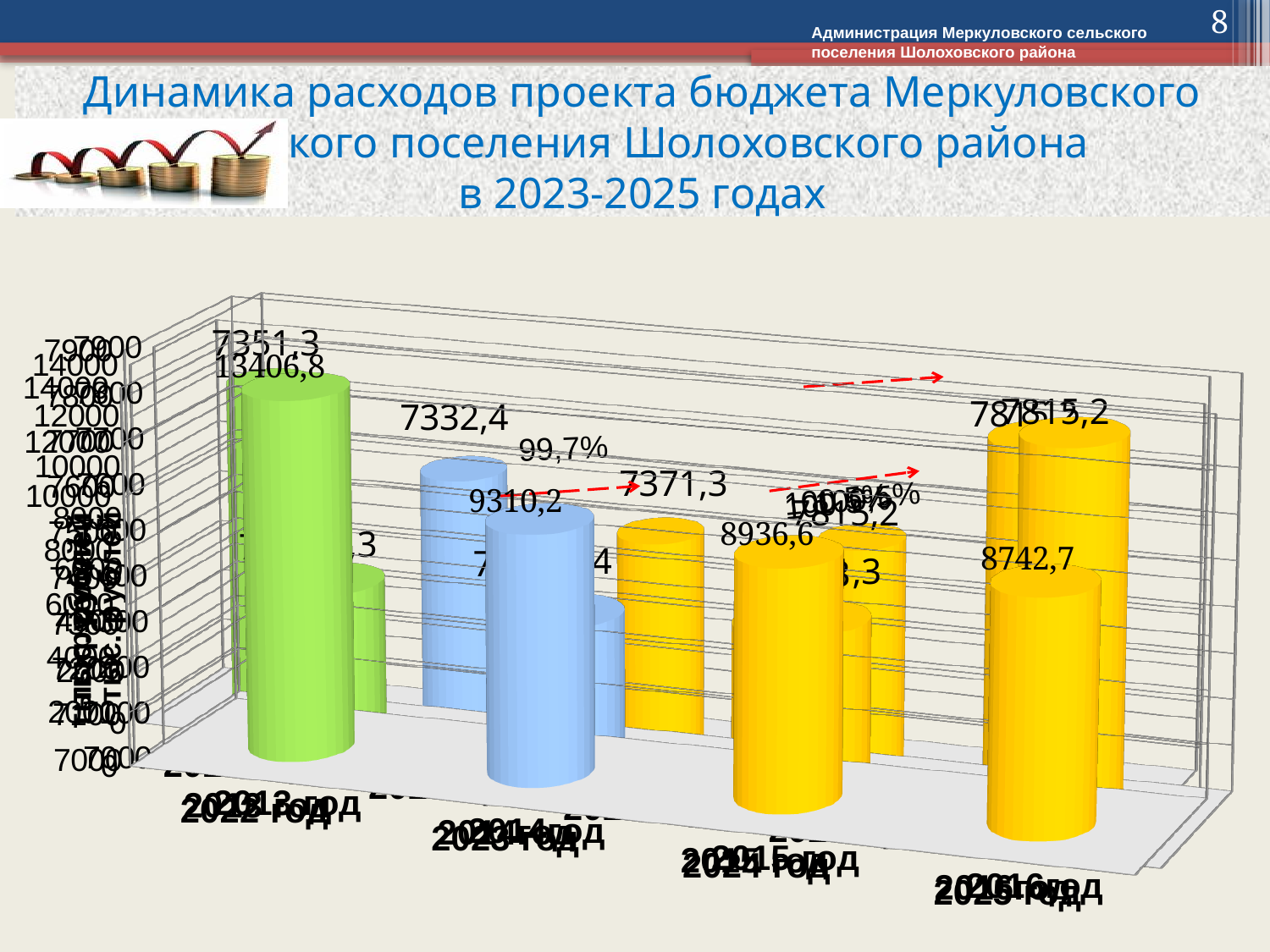
Among the foreground cylinders, which year has the highest value? 2022 год How many years are shown along the x axis of the foreground series? 4 In the foreground series, what is the difference between the values for 2023 год (9310,2) and 2024 год (8936,6)? 373,6 In the foreground series of cylinders, what value is labelled for 2024 год? 8936,6 In the foreground series, what is the difference between the values for 2022 год (13406,8) and 2023 год (9310,2)? 4096,6 Among the foreground cylinders, which year has the lowest value? 2025 год In the foreground series of cylinders, what value is labelled for 2023 год? 9310,2 In the foreground series of cylinders, what value is labelled for 2025 год? 8742,7 Do the values of the foreground cylinders rise or fall from 2022 год to 2025 год? fall In the foreground series, which is larger: the value for 2023 год or for 2024 год? 2023 год What kind of chart is shown on the slide? bar chart In the foreground series of cylinders, what value is labelled for 2022 год? 13406,8